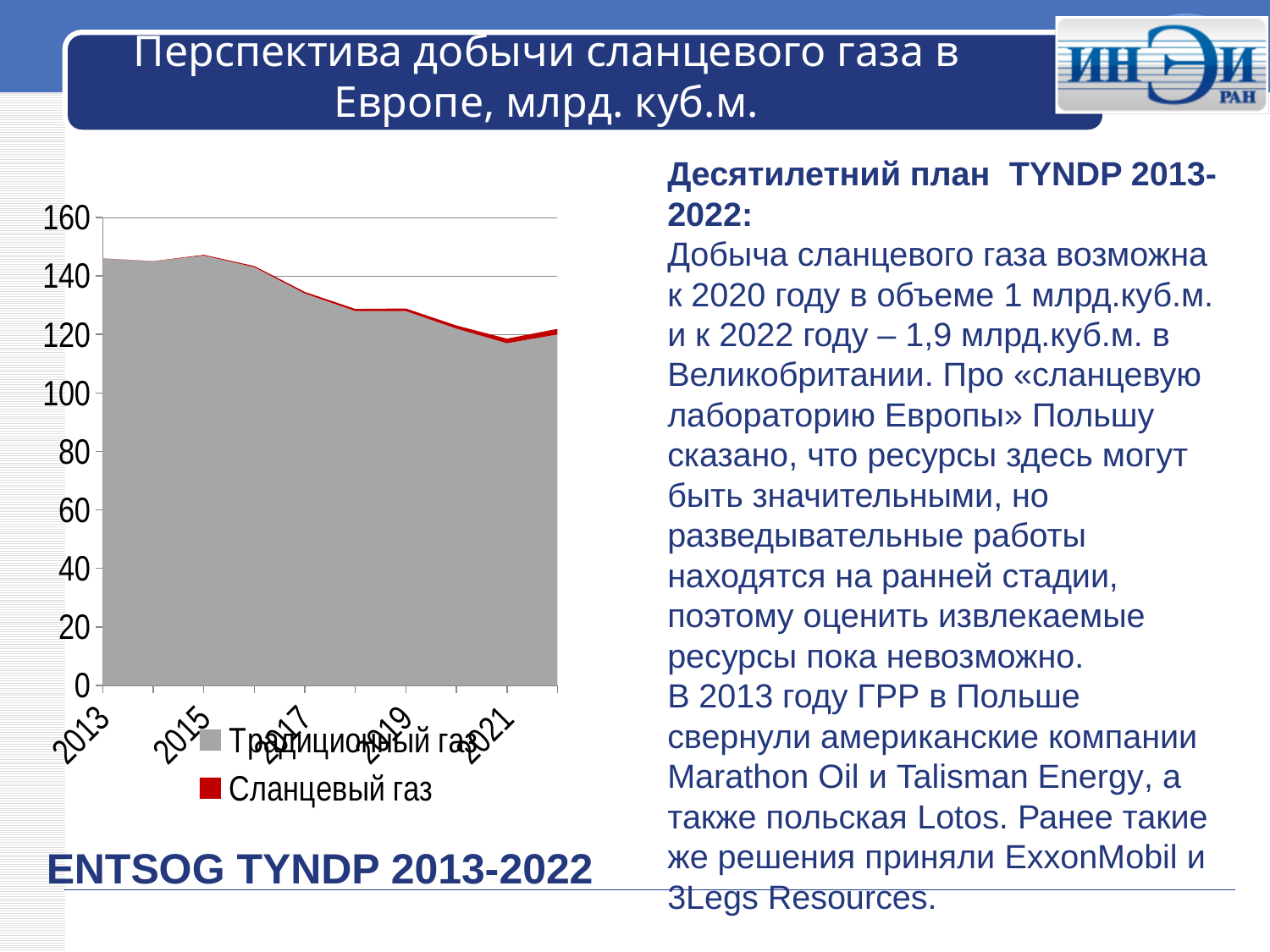
How many year labels are shown on the x axis of the chart? 5 Which series has larger values throughout the chart, Традиционный газ or Сланцевый газ? Традиционный газ How many series does the chart legend list? 2 What are the two series named in the chart legend? Традиционный газ and Сланцевый газ What kind of chart is shown on the slide? Stacked area chart Is the value for Традиционный газ in 2017 greater or less than 120? greater Which colour represents Сланцевый газ in the chart? Red Does the total gas production in the chart rise or fall from 2013 to 2021? Fall Is the value for Традиционный газ in 2019 greater or less than 140? less Is the value for Традиционный газ in 2013 greater or less than 140? greater Which year has the larger value for Традиционный газ, 2013 or 2021? 2013